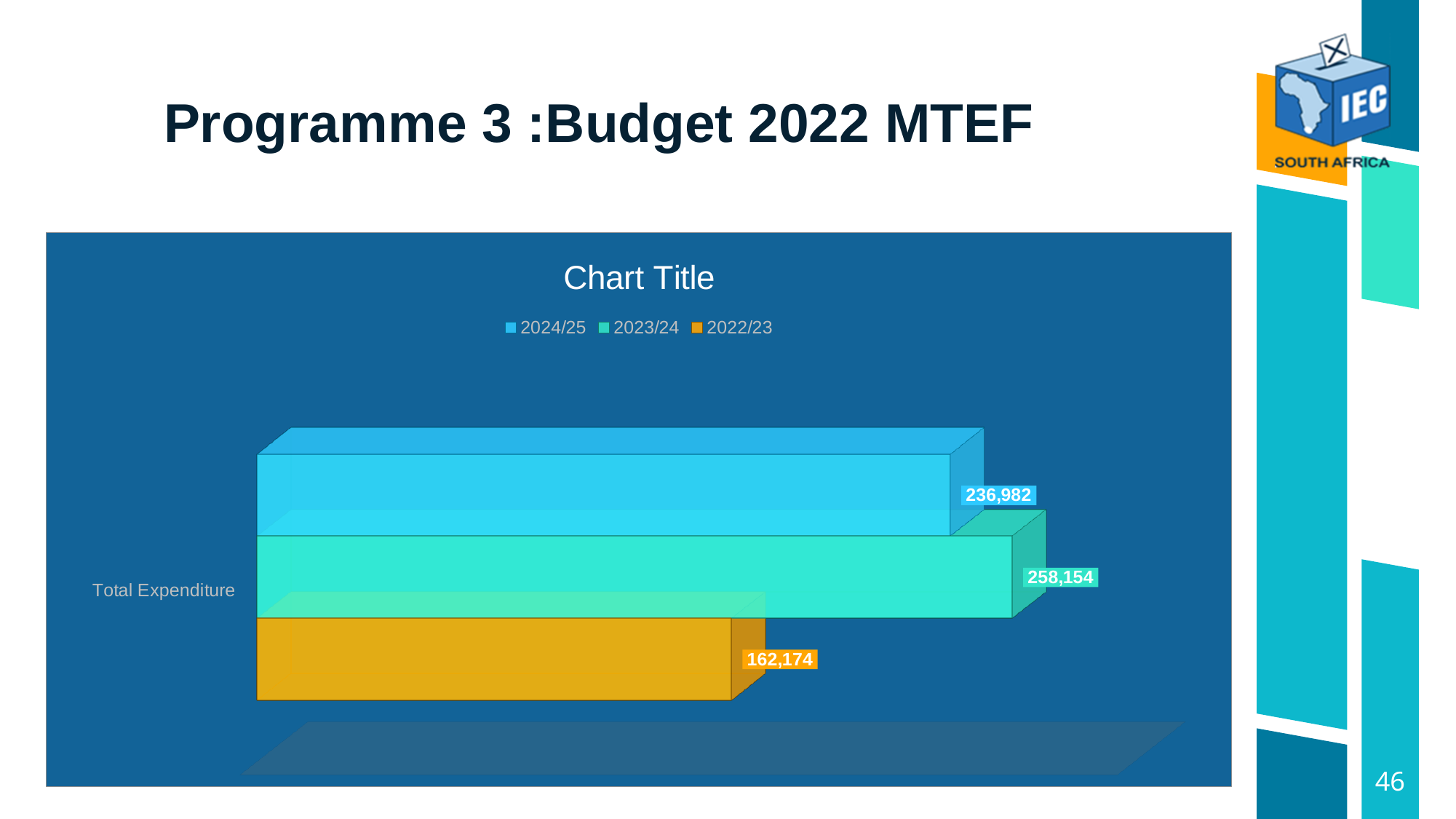
What is the title shown on the chart? Chart Title Which financial year has the lowest Total Expenditure? 2022/23 What is the Total Expenditure value for 2023/24? 258,154 How many series does the legend list? 3 What is the difference between the Total Expenditure for 2023/24 and 2022/23? 95,980 Which financial year has the highest Total Expenditure? 2023/24 What is the Total Expenditure value for 2022/23? 162,174 What kind of chart is shown on the slide? Bar chart What is the Total Expenditure value for 2024/25? 236,982 What is the difference between the Total Expenditure for 2024/25 and 2022/23? 74,808 Which is larger, the Total Expenditure for 2024/25 or for 2022/23? 2024/25 What is the difference between the Total Expenditure for 2023/24 and 2024/25? 21,172